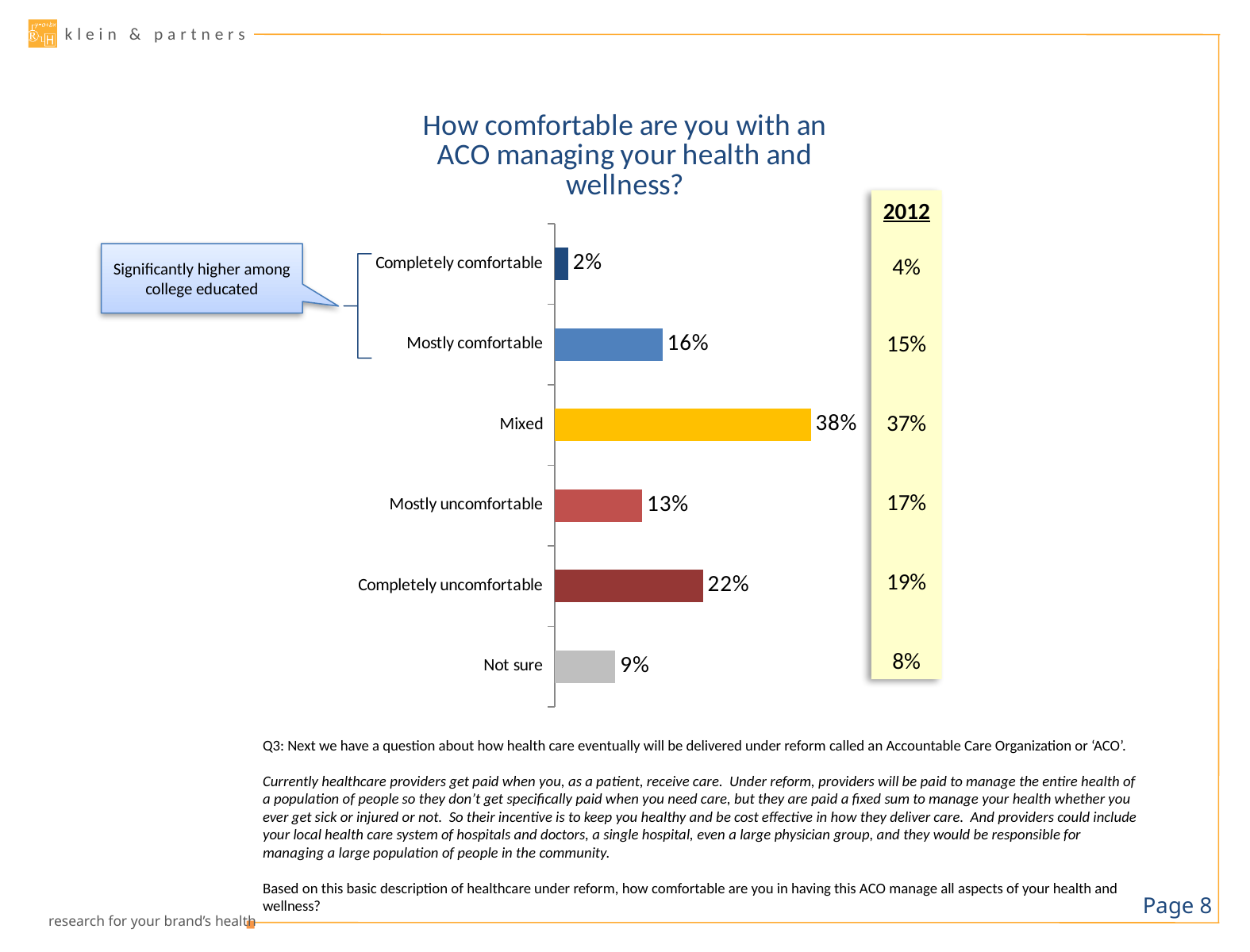
What is the difference between the values for Mostly comfortable and Completely comfortable? 14% What kind of chart is shown on the slide? Bar chart Which is larger, the value for Mostly comfortable or the value for Mostly uncomfortable? Mostly comfortable Which category has the highest value? Mixed What is the value for Completely uncomfortable? 22% What is the value for Mixed? 38% What is the value for Not sure? 9% What colour is the bar for Mixed? Yellow What is the difference between the values for Mixed and Completely uncomfortable? 16% Which category has the lowest value? Completely comfortable What is the title of the chart? How comfortable are you with an ACO managing your health and wellness? How many categories are shown in the chart? 6